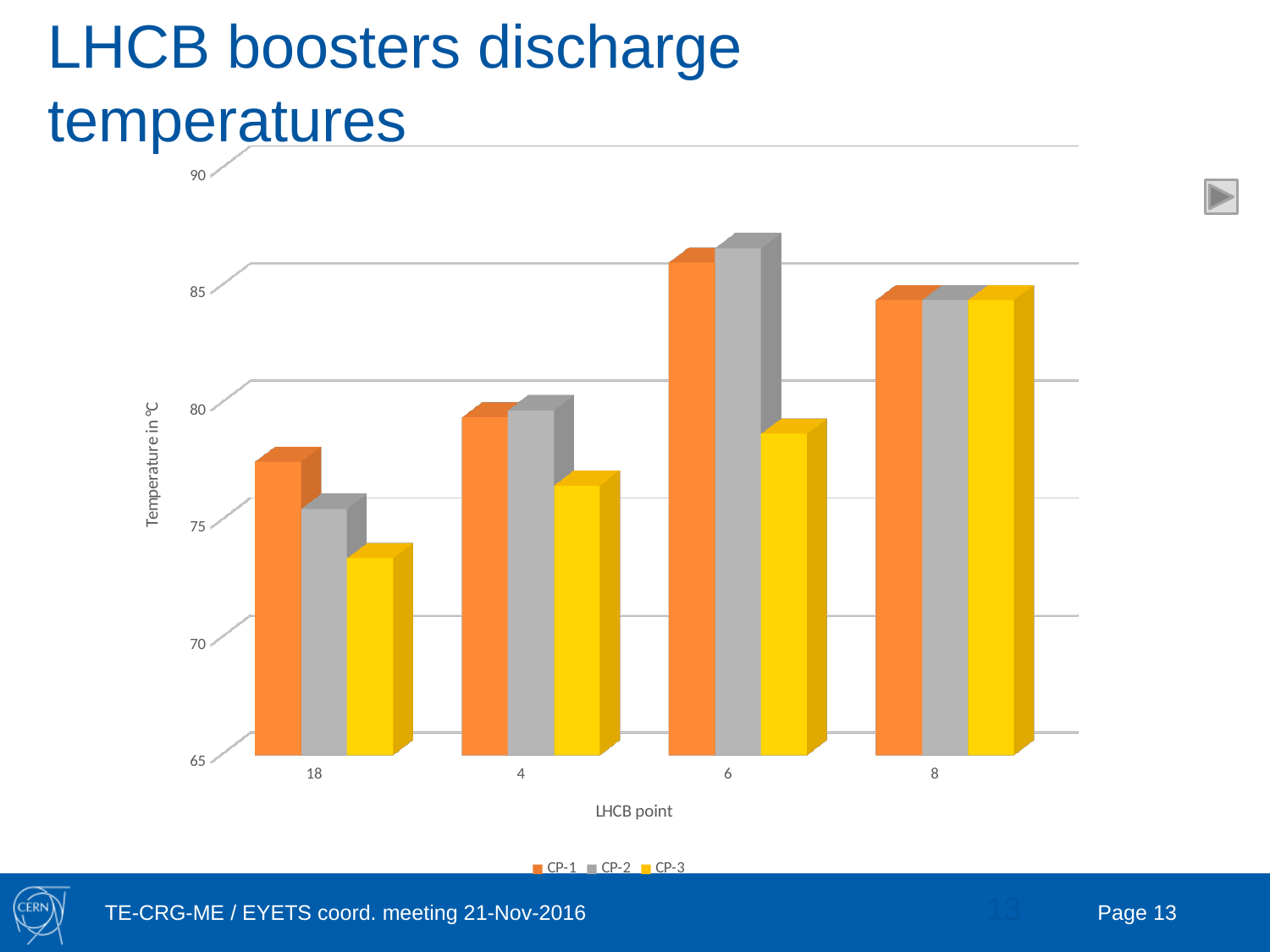
Is the CP-3 value at LHCB point 18 greater or less than 75? less At LHCB point 6, which is larger, the CP-1 value or the CP-3 value? CP-1 How many series does the legend list? 3 At which LHCB point is the CP-1 temperature highest? 6 At which LHCB point is the CP-3 temperature highest? 8 Is the CP-3 value at LHCB point 6 greater or less than 80? less What kind of chart is shown on the slide? bar chart Is the CP-1 value at LHCB point 6 greater or less than 85? greater At which LHCB point is the CP-1 temperature lowest? 18 What is the title of the vertical axis? Temperature in °C At which LHCB point is the CP-3 temperature lowest? 18 How many LHCB points are shown on the x axis? 4